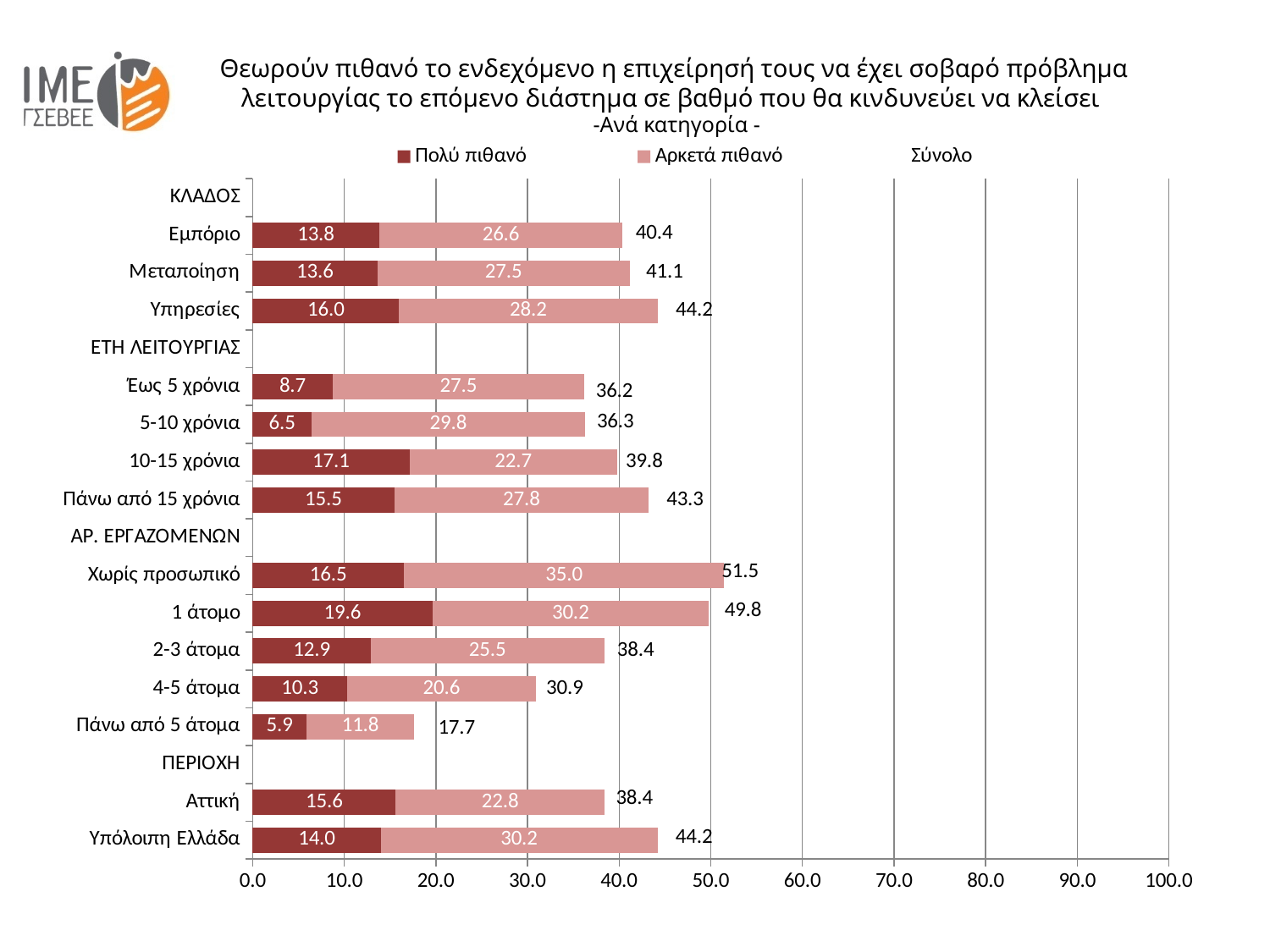
Which category has the highest total (Σύνολο)? Χωρίς προσωπικό How many categories have bars plotted in the chart? 14 Which category has the highest "Πολύ πιθανό" value? 1 άτομο How many series does the legend list? 3 Which category has the lowest total (Σύνολο)? Πάνω από 5 άτομα What type of chart is shown on the slide? Stacked bar chart What is the "Πολύ πιθανό" value for Υπηρεσίες? 16.0 Which has a larger "Αρκετά πιθανό" value, 5-10 χρόνια or 10-15 χρόνια? 5-10 χρόνια Is the total for Χωρίς προσωπικό greater or less than 50.0? greater What is the "Αρκετά πιθανό" value for Χωρίς προσωπικό? 35.0 What is the total (Σύνολο) for 1 άτομο? 49.8 What is the difference between the totals for Υπόλοιπη Ελλάδα and Αττική? 5.8